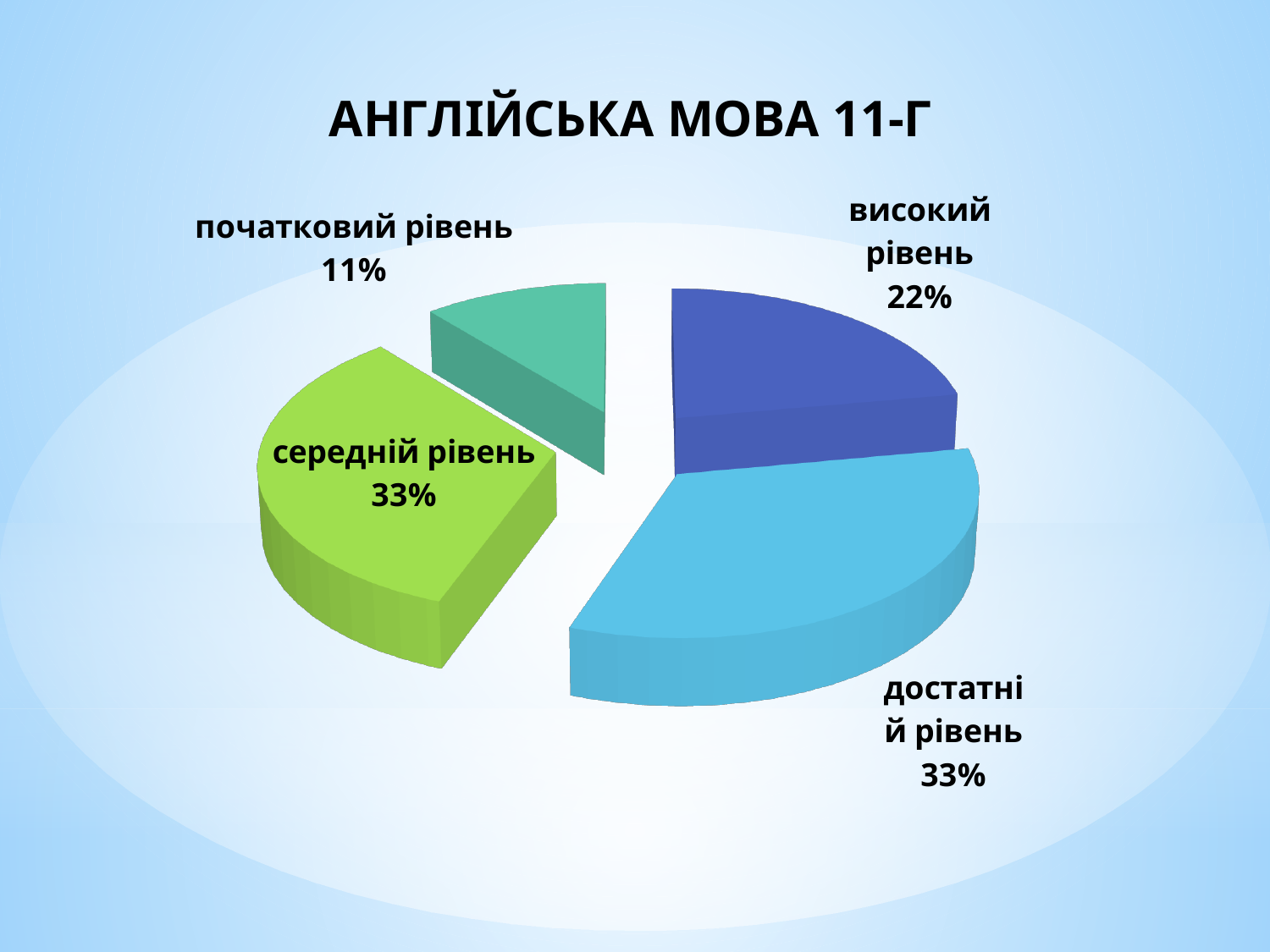
Which category has the smallest share of the pie? початковий рівень What share of the pie is labelled "середній рівень"? 33% What share of the pie is labelled "достатній рівень"? 33% What colour is the slice for "середній рівень"? green Which is larger: the share for "середній рівень" or the share for "високий рівень"? середній рівень What kind of chart is shown on the slide? pie chart How many slices does the pie chart have? 4 By how many percentage points does the share for "високий рівень" exceed the share for "початковий рівень"? 11 What share of the pie is labelled "високий рівень"? 22% What is the title of the chart? АНГЛІЙСЬКА МОВА 11-Г Which is larger: the share for "високий рівень" or the share for "початковий рівень"? високий рівень